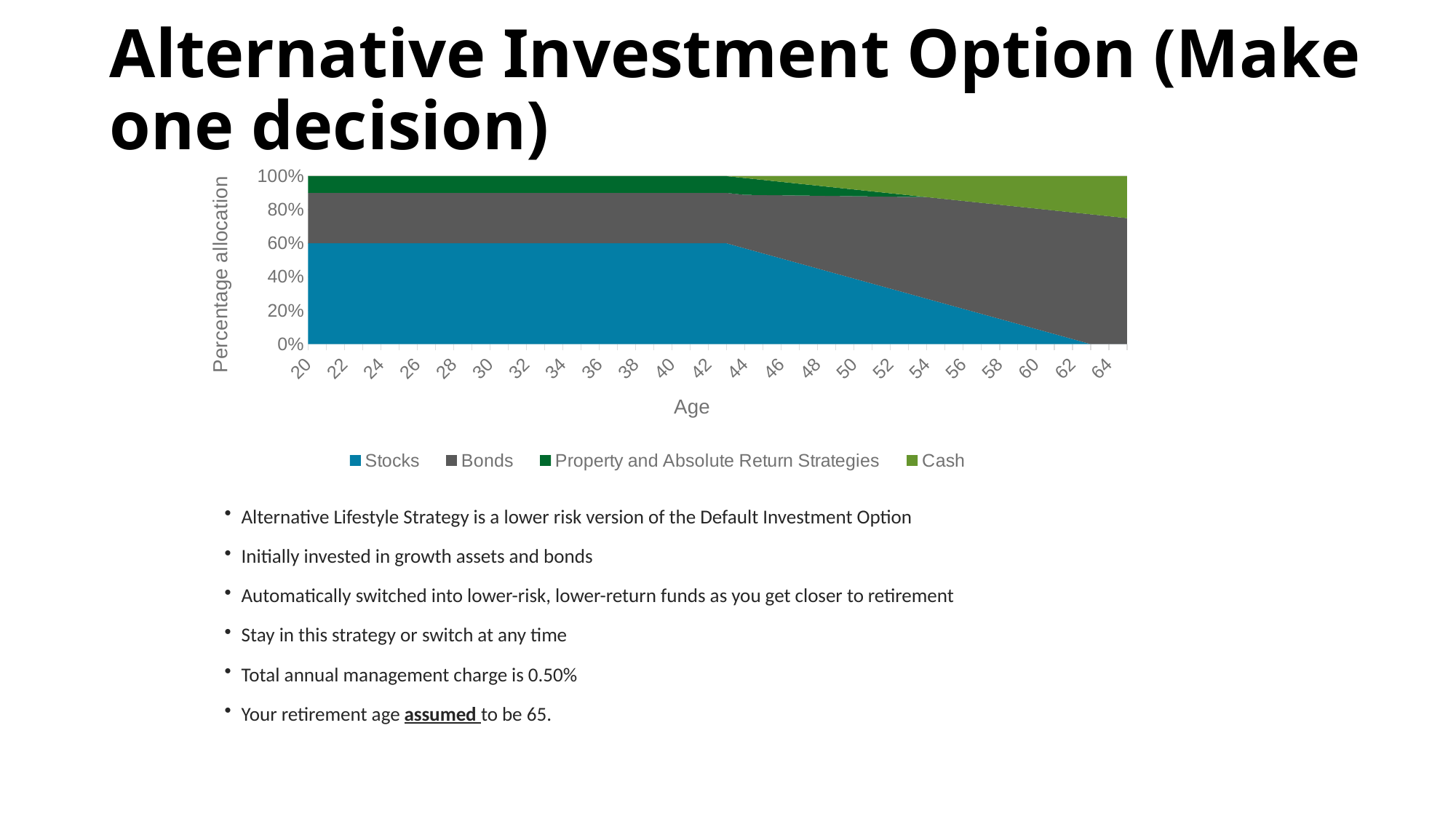
Does the allocation to Stocks rise or fall as age increases along the x axis? fall Is the allocation to Cash at age 30 greater or less than 20%? less At age 60, which is larger: the allocation to Stocks or to Bonds? Bonds What is the label of the y axis? Percentage allocation Does the allocation to Bonds rise or fall as age increases along the x axis? rise Is the allocation to Stocks at age 30 greater or less than 40%? greater Is the allocation to Stocks at age 60 greater or less than 20%? less At age 30, which is larger: the allocation to Stocks or to Bonds? Stocks What is the percentage allocation to Stocks at age 20? 60% What is the label of the x axis? Age What kind of chart is shown on the slide? area chart How many series does the legend list? 4